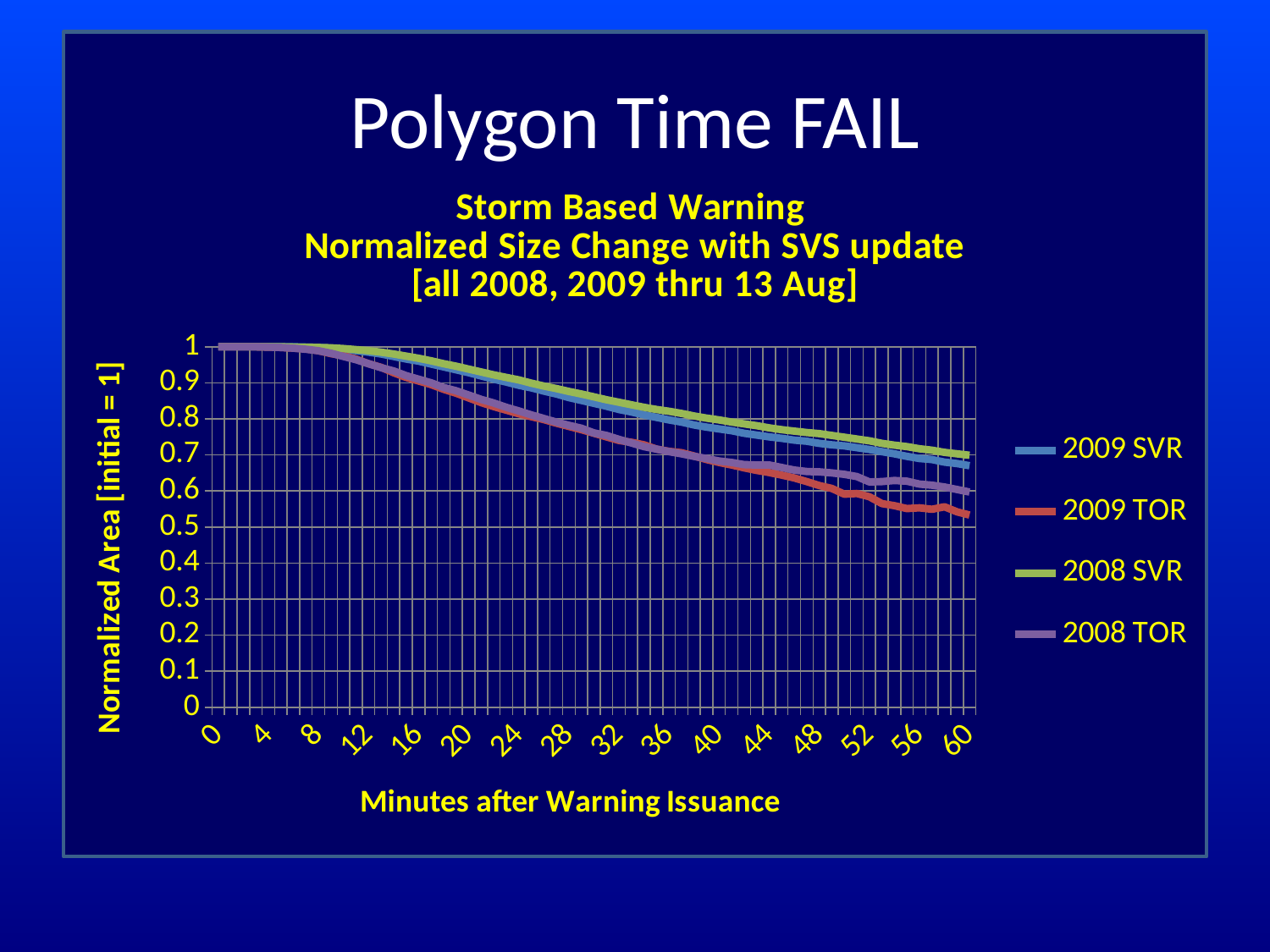
What is the value of the 2009 SVR series at 0 minutes after warning issuance? 1 What kind of chart is shown on the slide? line chart Which series has the lowest value at 60 minutes after warning issuance? 2009 TOR At 60 minutes, is the value for 2009 TOR greater or less than 0.5? greater At 20 minutes, is the value for 2008 SVR greater or less than 0.9? greater At 40 minutes, is the value for 2009 TOR greater or less than 0.7? less What is the title of the y axis? Normalized Area [initial = 1] Do the values of the 2009 TOR series rise or fall as minutes after warning issuance increase? fall At 60 minutes, which is larger: the value for 2008 SVR or the value for 2009 TOR? 2008 SVR How many series does the legend list? 4 What is the title of the x axis? Minutes after Warning Issuance